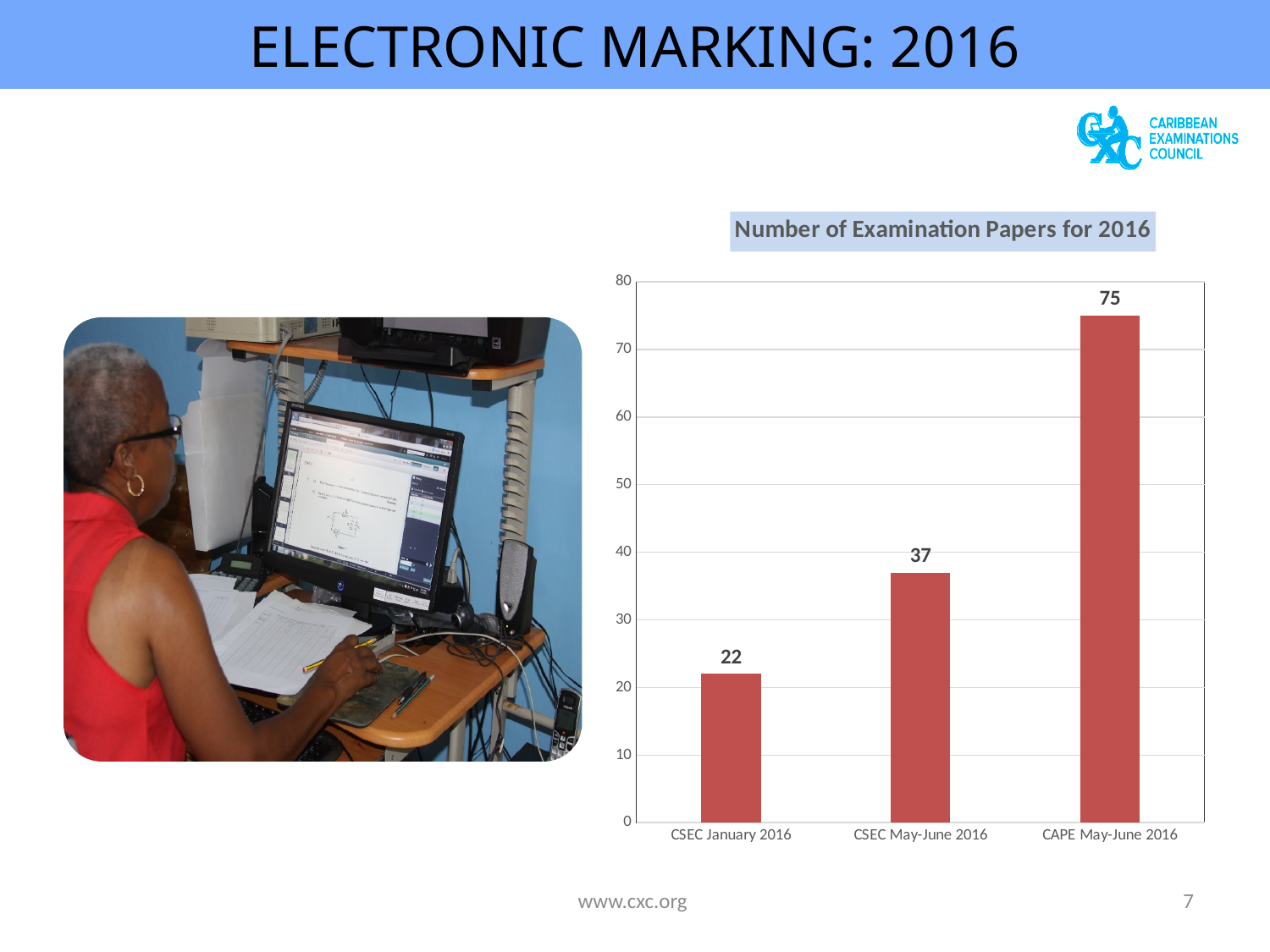
Which has more examination papers, CSEC January 2016 or CSEC May-June 2016? CSEC May-June 2016 What is the number of examination papers for CSEC May-June 2016? 37 What kind of chart is shown on the slide? Bar chart What is the number of examination papers for CSEC January 2016? 22 Which category has the lowest number of examination papers? CSEC January 2016 What is the title of the chart? Number of Examination Papers for 2016 Which category has the highest number of examination papers? CAPE May-June 2016 Is the value for CAPE May-June 2016 greater or less than 70? greater How many categories are shown on the chart? 3 What is the difference between the number of papers for CSEC May-June 2016 and CSEC January 2016? 15 What is the number of examination papers for CAPE May-June 2016? 75 What is the difference between the number of papers for CAPE May-June 2016 and CSEC May-June 2016? 38